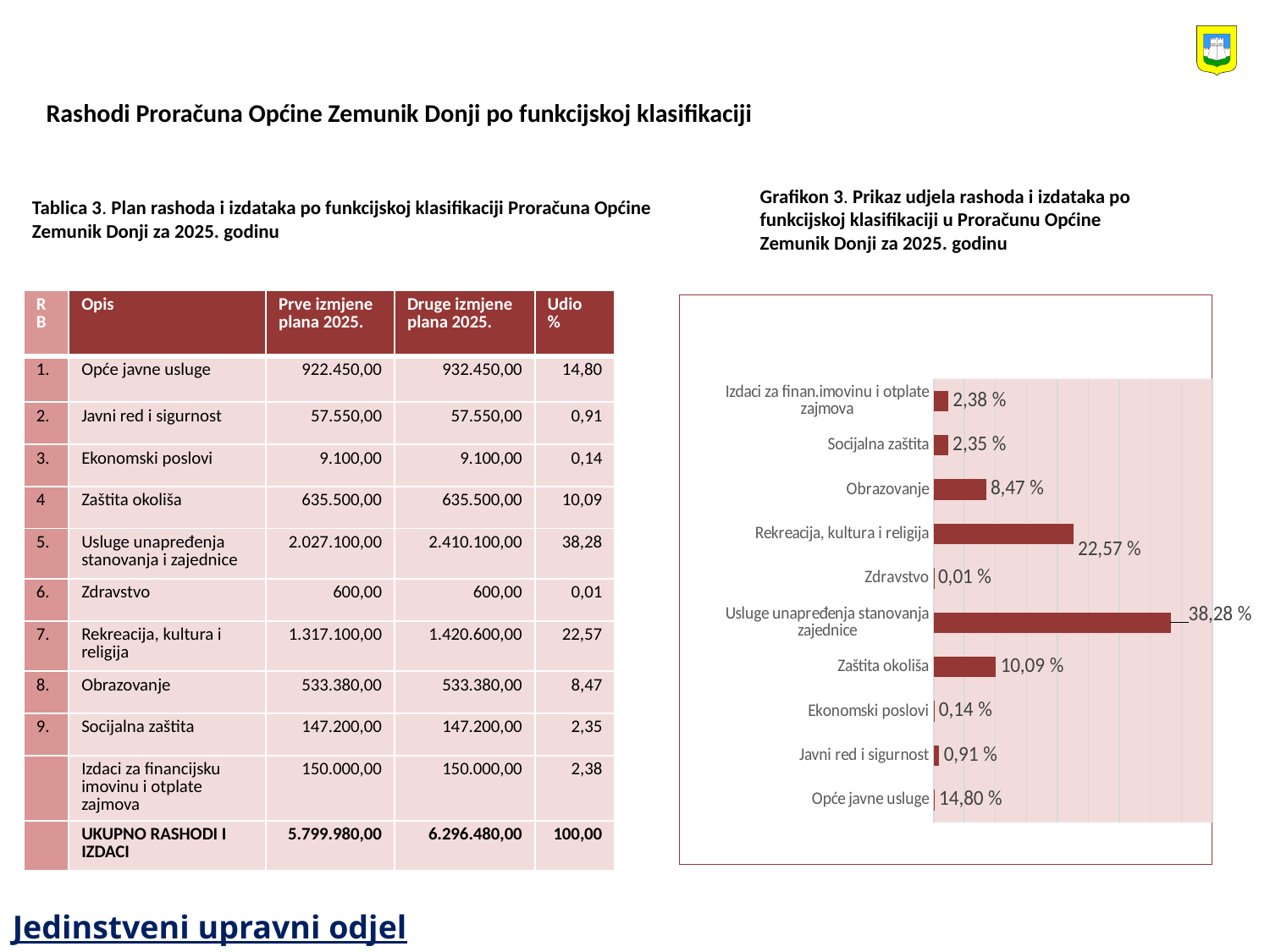
What kind of chart is shown on the slide? Bar chart What is the value shown for Rekreacija, kultura i religija? 22,57 % What is the difference between the values for Usluge unapređenja stanovanja zajednice and Rekreacija, kultura i religija? 15,71 % What is the value shown for Usluge unapređenja stanovanja zajednice? 38,28 % Which is larger, the value for Obrazovanje or the value for Zaštita okoliša? Zaštita okoliša Which category has the highest value in the chart? Usluge unapređenja stanovanja zajednice What is the value shown for Izdaci za finan.imovinu i otplate zajmova? 2,38 % What is the value shown for Zaštita okoliša? 10,09 % What is the title of the chart? Grafikon 3. Prikaz udjela rashoda i izdataka po funkcijskoj klasifikaciji u Proračunu Općine Zemunik Donji za 2025. godinu What is the value shown for Socijalna zaštita? 2,35 % Which category has the lowest value in the chart? Zdravstvo How many categories are shown in the chart? 10